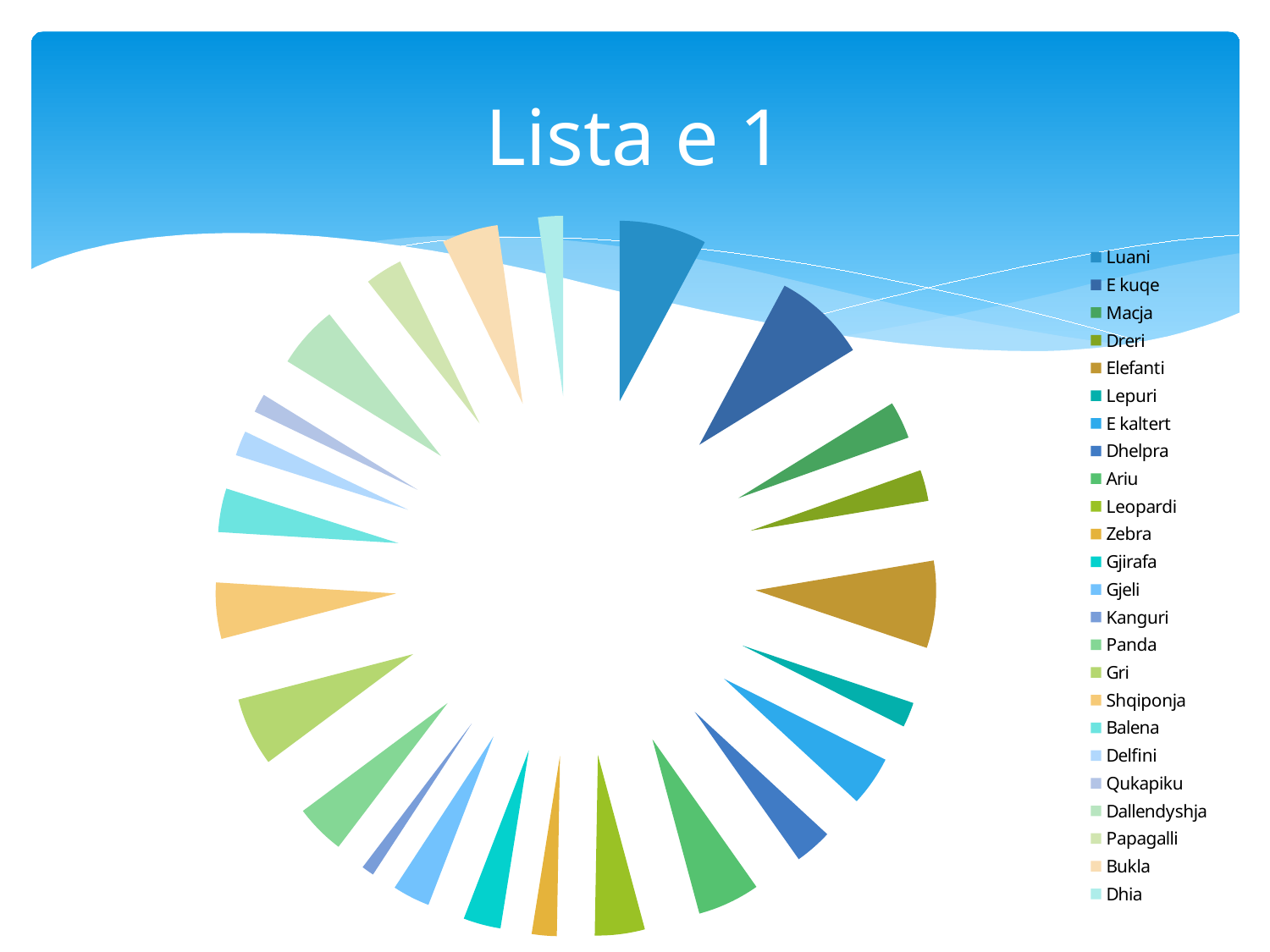
Which slice is larger in the pie chart, Elefanti or Qukapiku? Elefanti What kind of chart is shown on the slide? pie chart Which slice is larger in the pie chart, E kuqe or Delfini? E kuqe Which category is listed first in the legend of the pie chart? Luani Which slice is larger in the pie chart, Luani or Dhia? Luani What is the title of the chart on the slide? Lista e 1 How many categories does the legend of the pie chart list? 24